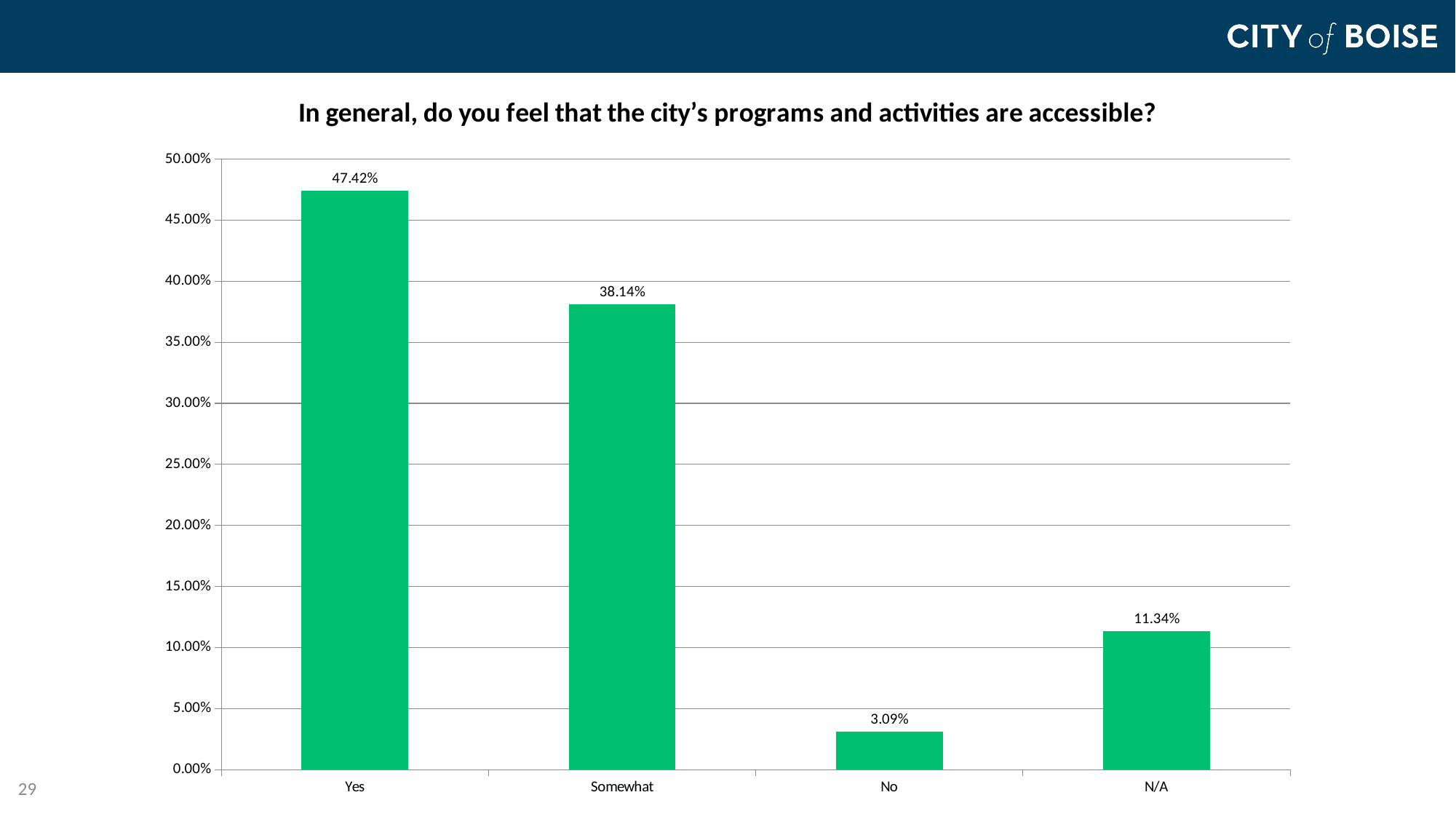
Which response category has the lowest percentage? No Which response category has the highest percentage? Yes What percentage of respondents answered "No"? 3.09% What percentage of respondents answered "Yes"? 47.42% What percentage of respondents answered "Somewhat"? 38.14% What percentage of respondents answered "N/A"? 11.34% What kind of chart is shown on the slide? Bar chart Which is larger, the value for "N/A" or the value for "No"? N/A What is the title of the chart? In general, do you feel that the city's programs and activities are accessible? Is the value for "Somewhat" greater or less than 40.00%? less How many response categories are shown on the x axis? 4 What is the difference in percentage points between "Yes" and "Somewhat"? 9.28%